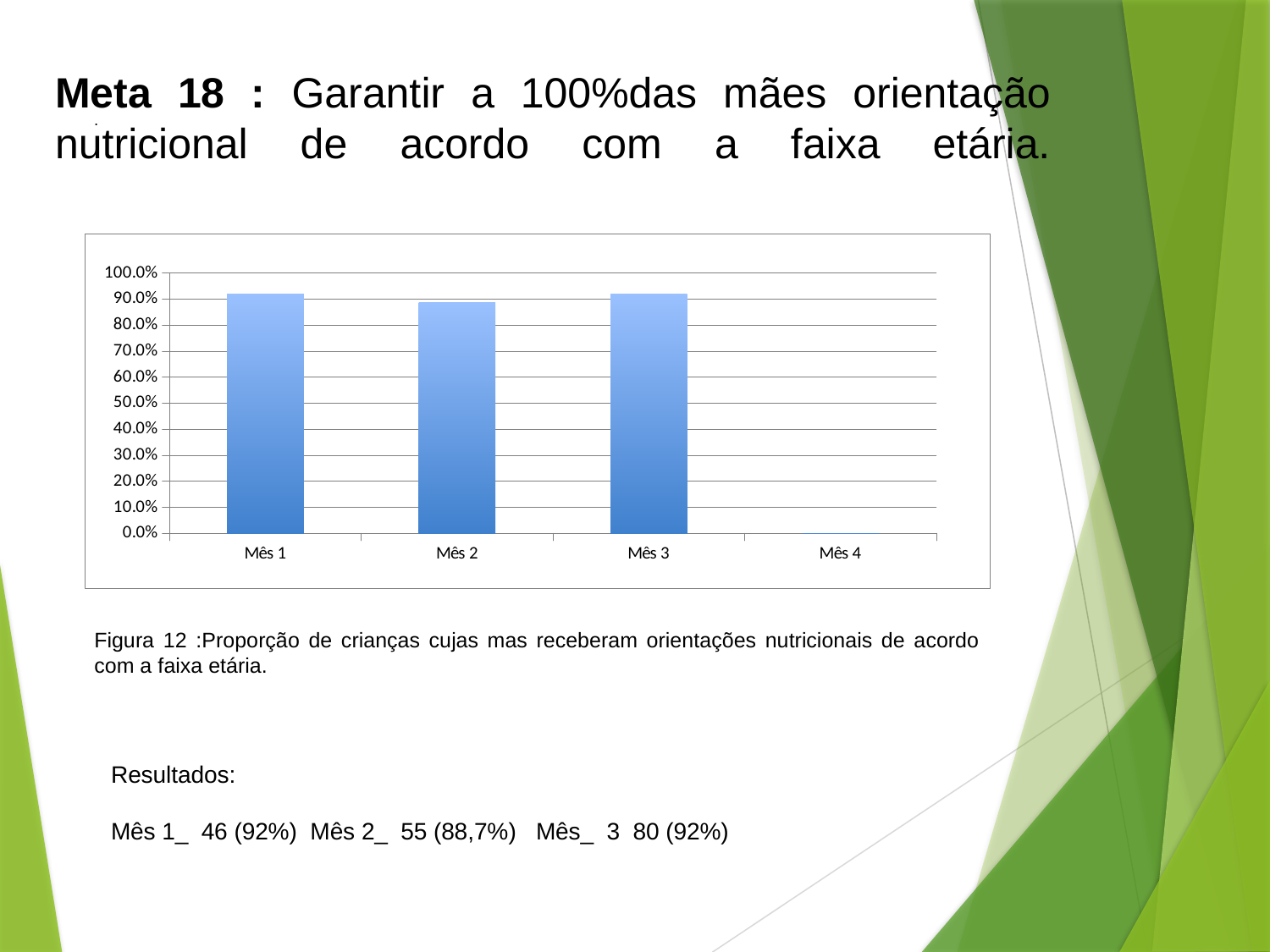
What is the highest tick value shown on the y axis of the chart? 100.0% What is the label of the fourth category on the x axis? Mês 4 According to the results text on the slide, what percentage is given for Mês 1? 92% Which is larger, the value for Mês 1 or the value for Mês 2? Mês 1 Is the value for Mês 3 greater or less than 90.0%? greater According to the results text on the slide, what percentage is given for Mês 2? 88,7% What kind of chart is shown on the slide? bar chart Is the value for Mês 2 greater or less than 90.0%? less Is the value for Mês 1 greater or less than 80.0%? greater Which is larger, the value for Mês 3 or the value for Mês 2? Mês 3 How many categories are shown on the x axis of the chart? 4